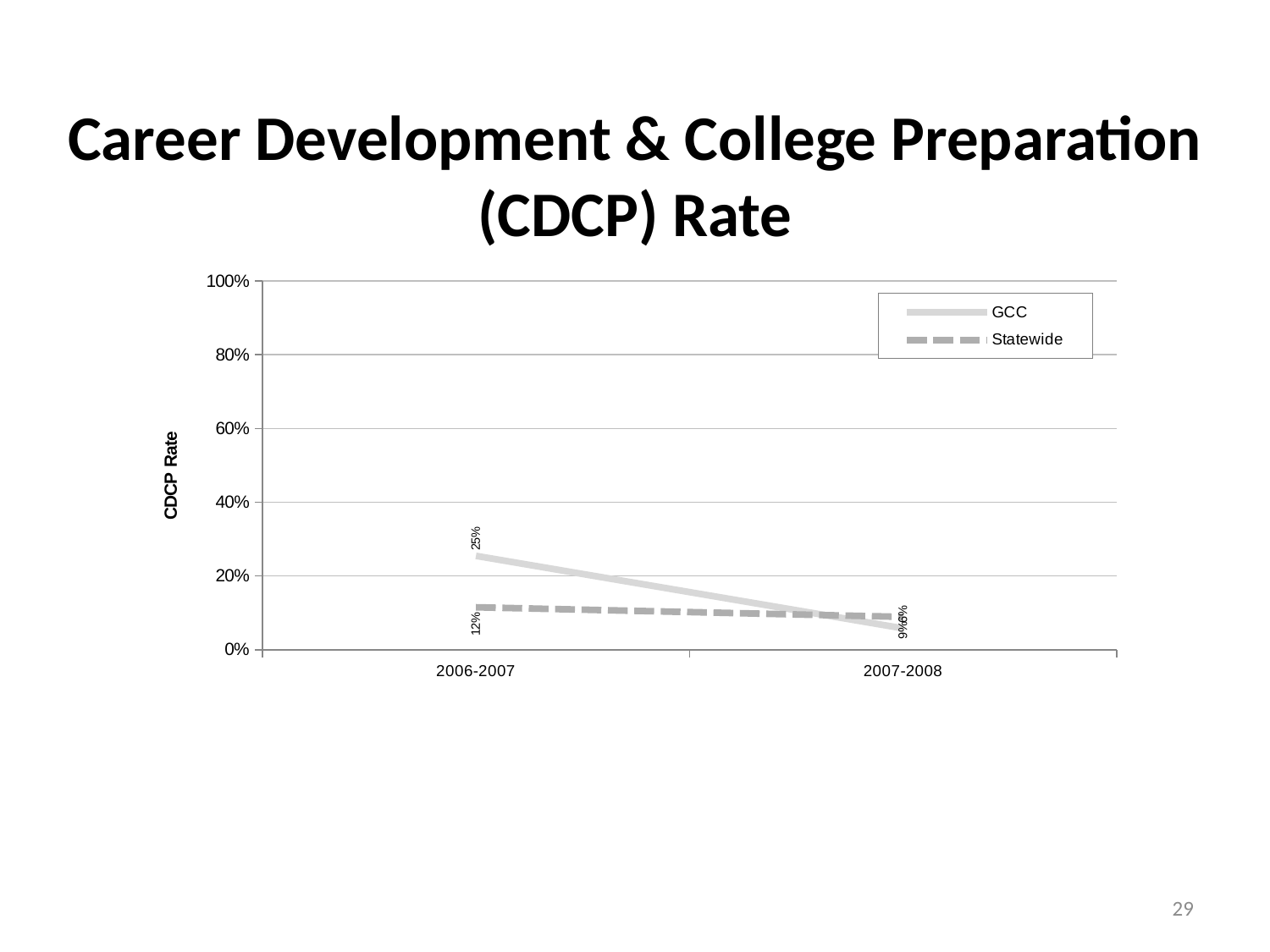
Which two series are listed in the legend? GCC and Statewide What is the label of the y axis? CDCP Rate In 2006-2007, which series has the higher CDCP rate, GCC or Statewide? GCC What is the GCC CDCP rate for 2006-2007? 25% Does the GCC CDCP rate rise or fall from 2006-2007 to 2007-2008? fall What kind of chart is shown on the slide? line chart What is the difference between the GCC and Statewide rates in 2006-2007? 13% What is the Statewide CDCP rate for 2006-2007? 12% How many series does the legend list? 2 Is the GCC value for 2007-2008 greater or less than 20%? less In 2007-2008, which series has the higher CDCP rate, GCC or Statewide? Statewide How many academic years are shown on the x axis? 2